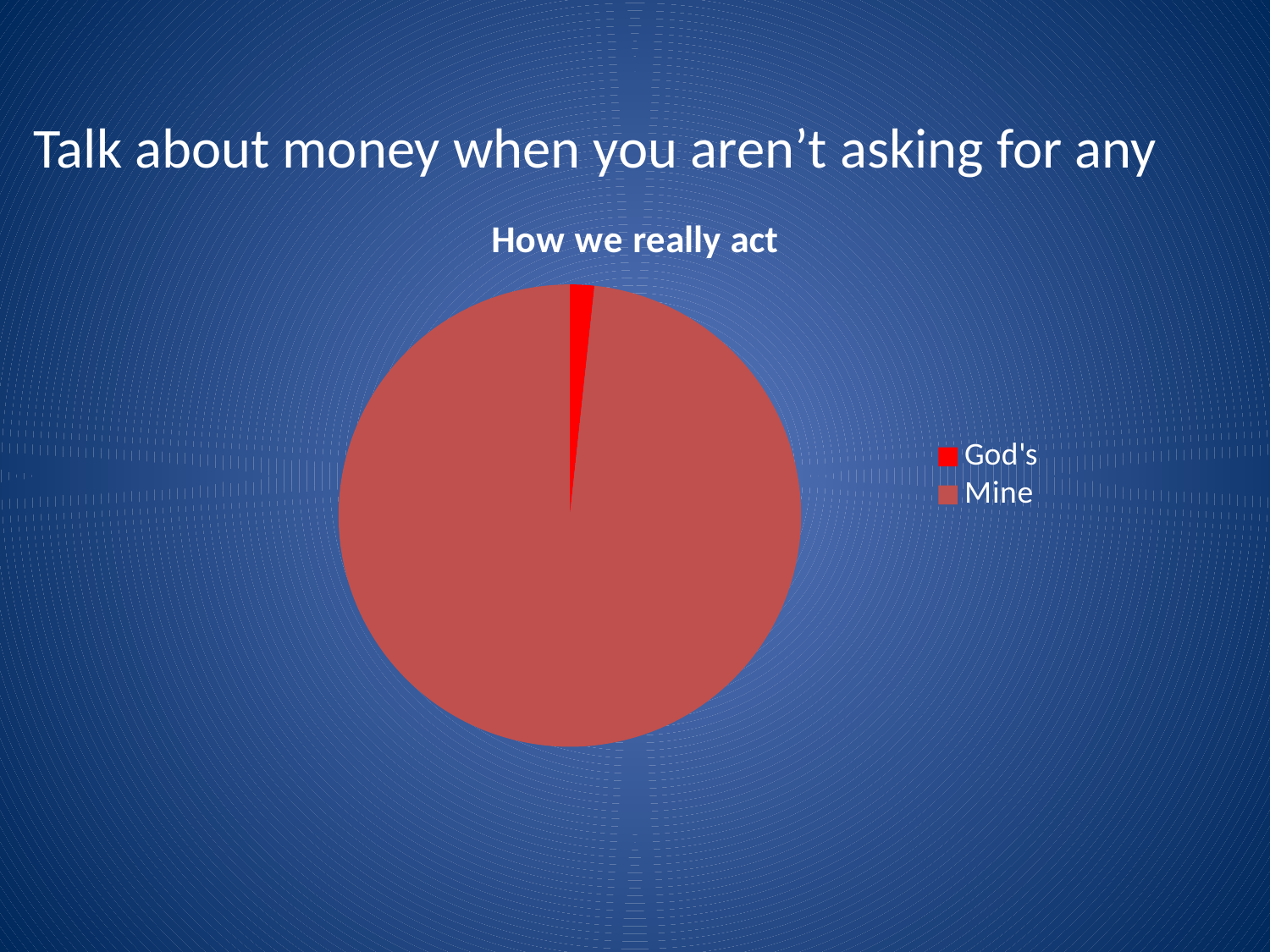
How many slices does the pie chart have? 2 What colour is the slice for God's in the legend? red Which slice is the smallest in the pie chart? God's What is the title of the chart? How we really act How many entries does the legend list? 2 Which slice is the largest in the pie chart? Mine What kind of chart is shown on the slide? pie chart Which slice is larger, God's or Mine? Mine